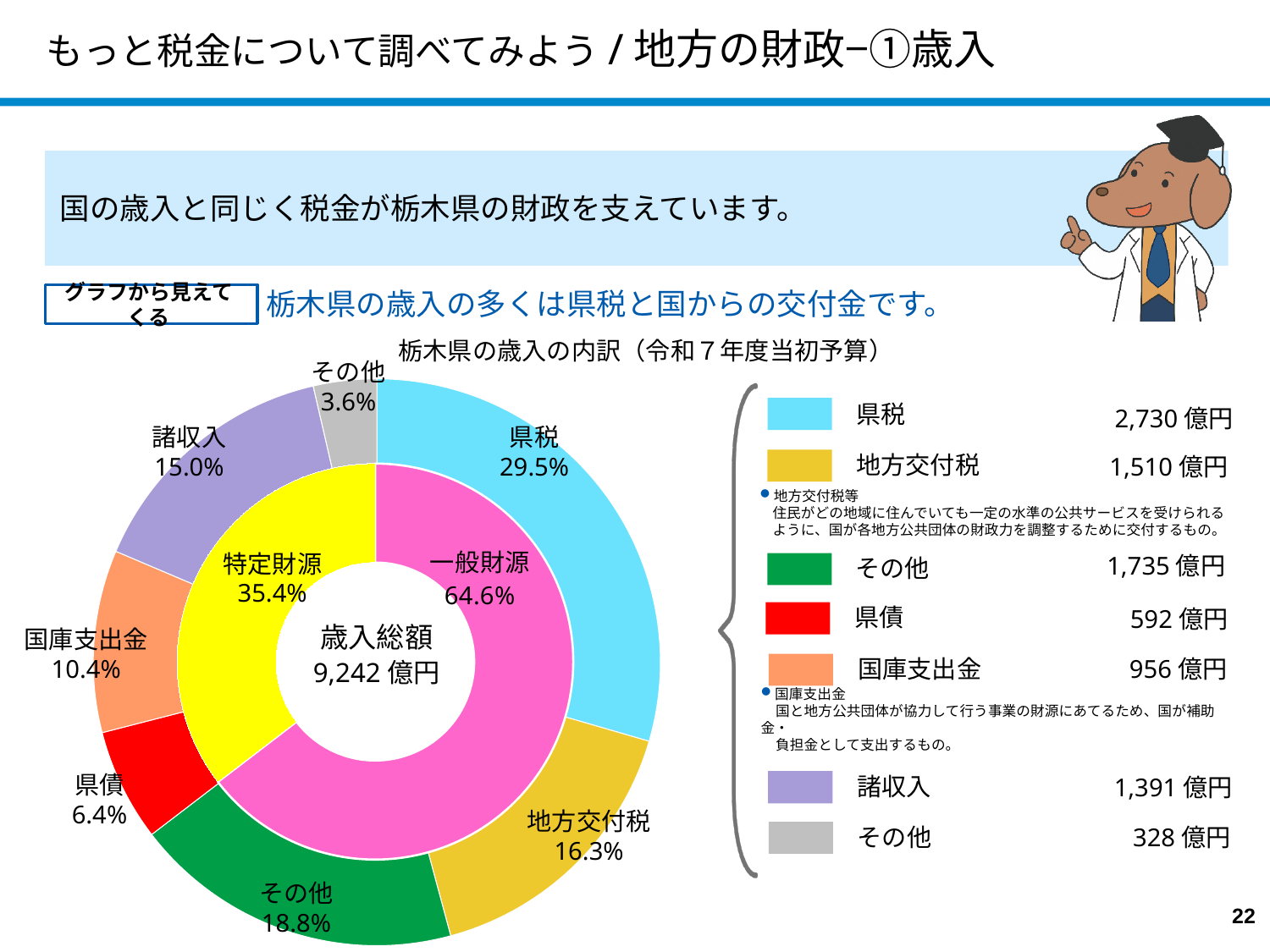
Which is larger, the share of 諸収入 or the share of 県債? 諸収入 Which category in the outer ring has the largest share? 県税 What share of the outer ring does 地方交付税 represent? 16.3% How many categories are shown in the outer ring of the chart? 7 What is the difference in percentage points between 一般財源 and 特定財源 in the inner ring? 29.2 percentage points What is the total revenue (歳入総額) shown in the centre of the chart? 9,242 億円 What kind of chart is shown on the slide? Donut (pie) chart What share of the outer ring does 国庫支出金 represent? 10.4% What share of the outer ring does 県税 represent? 29.5% According to the legend, what is the amount for 県債? 592 億円 Which category in the outer ring has the smallest share? その他 (3.6%, grey) What is the title of the chart? 栃木県の歳入の内訳（令和７年度当初予算）